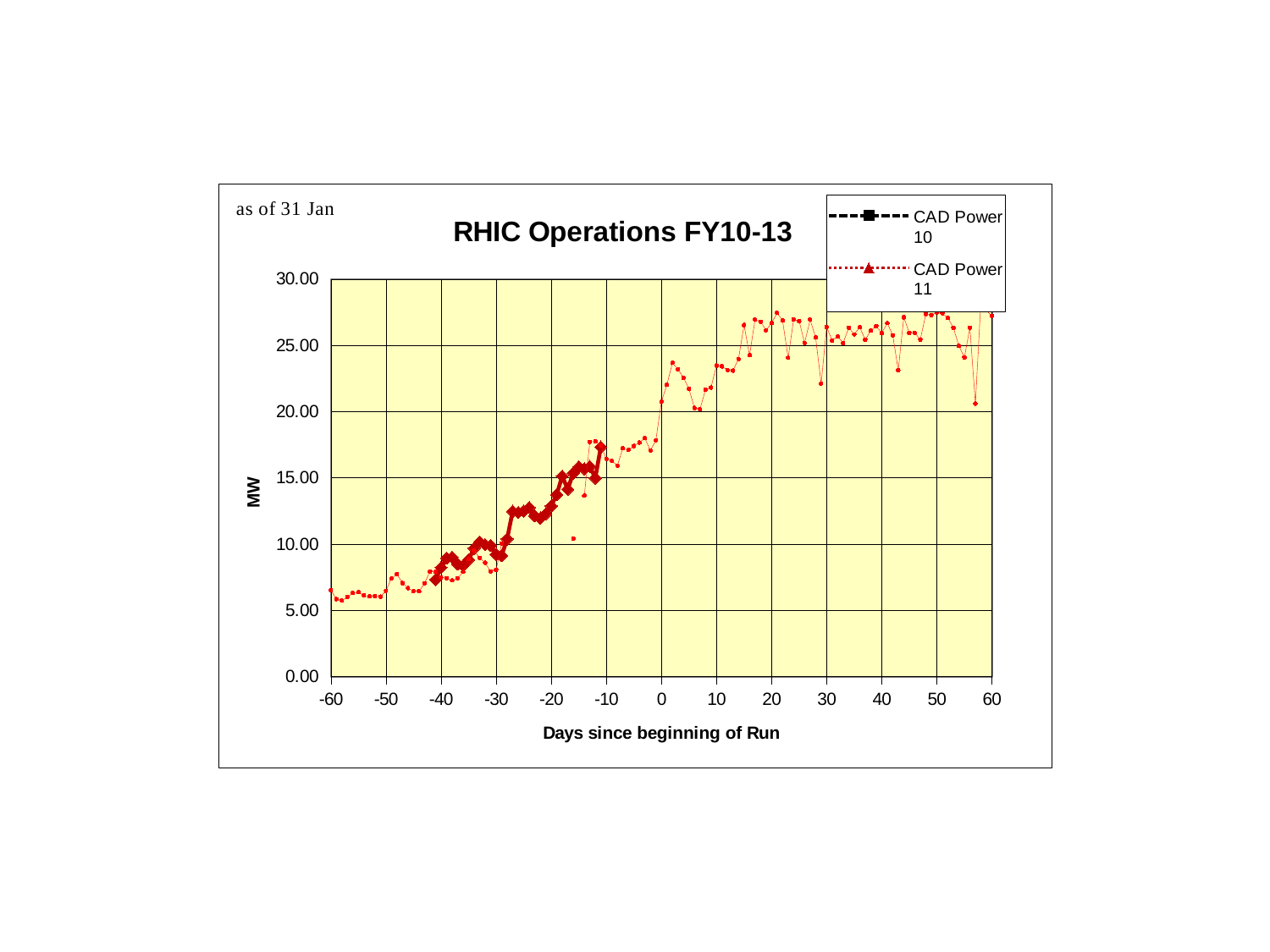
How many series does the chart legend list? 2 Is the CAD Power 11 value at day -40 greater or less than 10.00 MW? less Is the CAD Power 11 value at day 10 greater or less than 25.00 MW? less Does the CAD Power 11 series generally rise or fall from day -60 to day 20? rise What is the label of the y axis? MW What is the title of the chart? RHIC Operations FY10-13 Is the CAD Power 11 value at day 40 greater or less than 20.00 MW? greater What kind of chart is shown on the slide? line chart